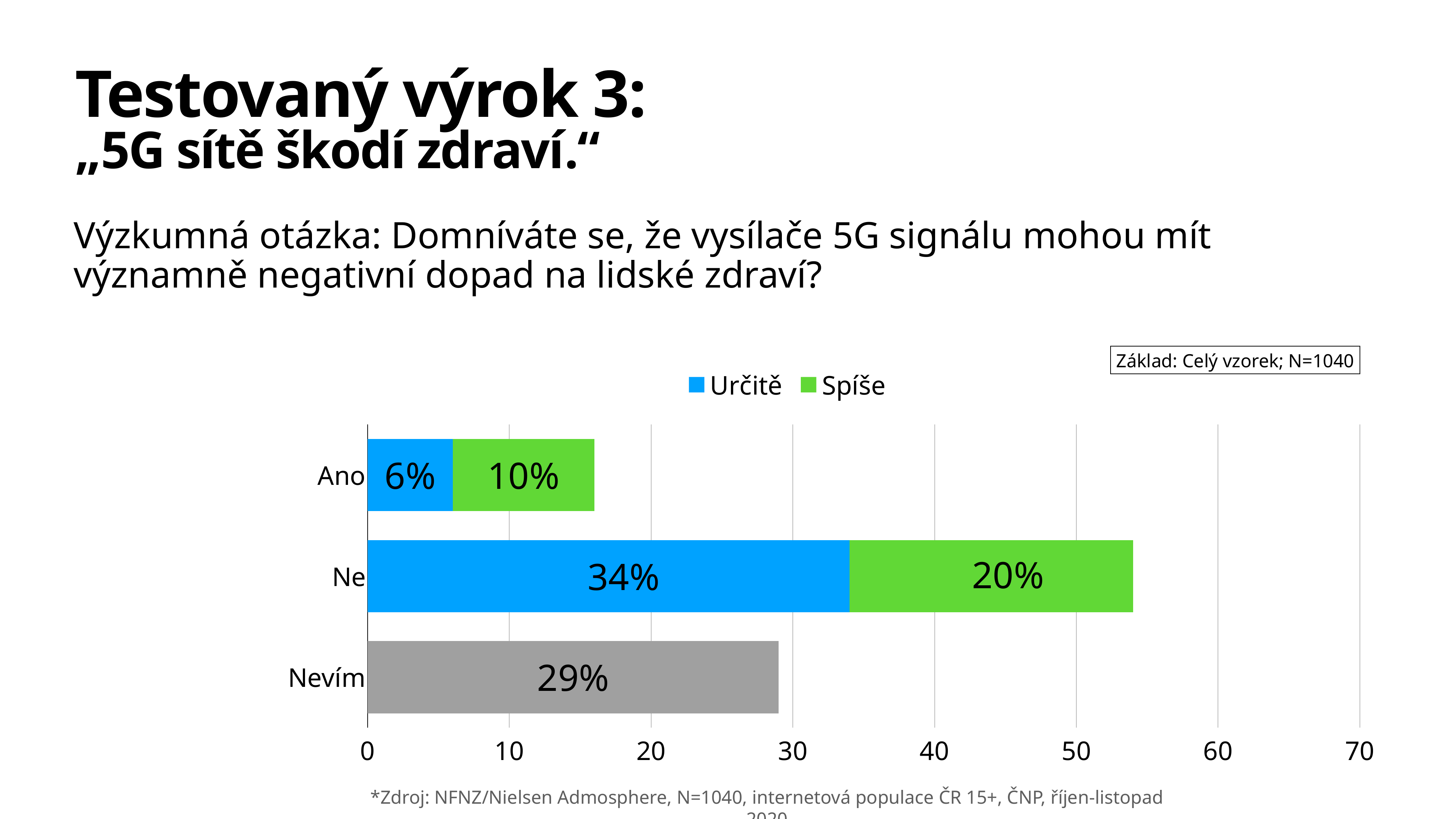
What is the 'Spíše' value for the 'Ano' category? 10% Which is larger: the 'Spíše' value for 'Ne' or the 'Spíše' value for 'Ano'? Ne What is the total of the stacked bar for 'Ano'? 16% Which category has the longest bar overall? Ne How many series does the legend list? 2 What is the difference between the 'Určitě' values for 'Ne' and 'Ano'? 28% How many categories are shown on the vertical axis? 3 What is the 'Určitě' value for the 'Ano' category? 6% What kind of chart is shown on the slide? Bar chart What is the total of the stacked bar for 'Ne'? 54% What is the 'Určitě' value for the 'Ne' category? 34% What is the value shown for the 'Nevím' category? 29%